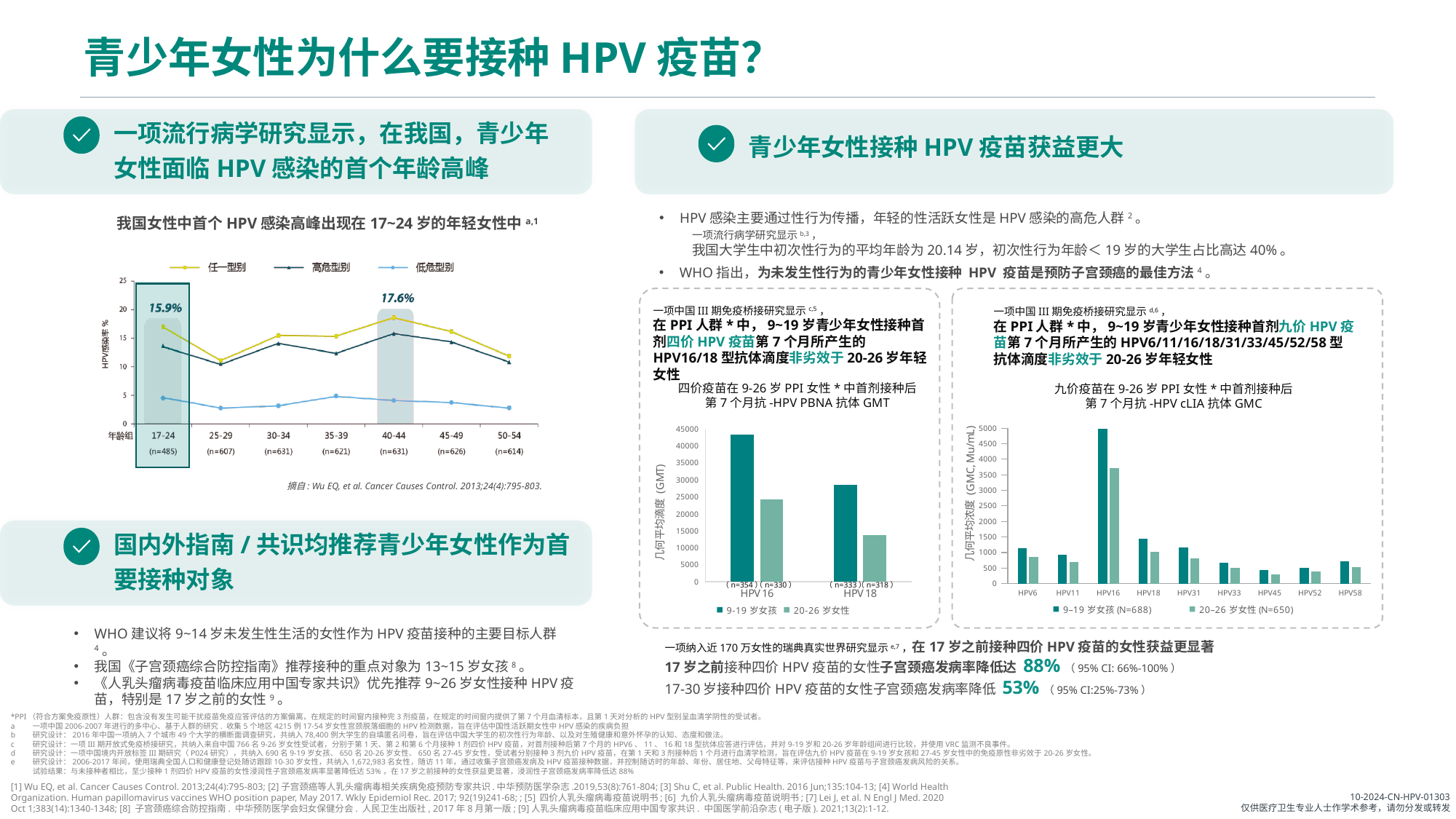
On the bar chart titled 四价疫苗在 9-26 岁 PPI 女性 * 中首剂接种后第 7 个月抗 -HPV PBNA 抗体 GMT, is the value for 9-19 岁女孩 at HPV 16 greater or less than 40000? greater On the bar chart titled 九价疫苗在 9-26 岁 PPI 女性 * 中首剂接种后第 7 个月抗 -HPV cLIA 抗体 GMC, is the value for 20–26 岁女性 (N=650) at HPV16 greater or less than 3000? greater On the line chart titled 我国女性中首个 HPV 感染高峰出现在 17~24 岁的年轻女性中, is the 低危型别 value for the 35-39 age group greater or less than 10? less On the bar chart titled 四价疫苗在 9-26 岁 PPI 女性 * 中首剂接种后第 7 个月抗 -HPV PBNA 抗体 GMT, which is larger at HPV 18: 9-19 岁女孩 or 20-26 岁女性? 9-19 岁女孩 On the line chart titled 我国女性中首个 HPV 感染高峰出现在 17~24 岁的年轻女性中, what is the labelled value for the 40-44 age group? 17.6% On the line chart titled 我国女性中首个 HPV 感染高峰出现在 17~24 岁的年轻女性中, which series has the lowest values across all age groups? 低危型别 On the bar chart titled 九价疫苗在 9-26 岁 PPI 女性 * 中首剂接种后第 7 个月抗 -HPV cLIA 抗体 GMC, how many HPV types are shown on the x axis? 9 On the bar chart titled 九价疫苗在 9-26 岁 PPI 女性 * 中首剂接种后第 7 个月抗 -HPV cLIA 抗体 GMC, which HPV type has the highest value for 9–19 岁女孩 (N=688)? HPV16 What kind of chart is the one titled 四价疫苗在 9-26 岁 PPI 女性 * 中首剂接种后第 7 个月抗 -HPV PBNA 抗体 GMT? bar chart On the line chart titled 我国女性中首个 HPV 感染高峰出现在 17~24 岁的年轻女性中, how many series does the legend list? 3 On the line chart titled 我国女性中首个 HPV 感染高峰出现在 17~24 岁的年轻女性中, what is the labelled value for the 17-24 age group? 15.9% On the line chart titled 我国女性中首个 HPV 感染高峰出现在 17~24 岁的年轻女性中, how many age groups are shown on the x axis? 7